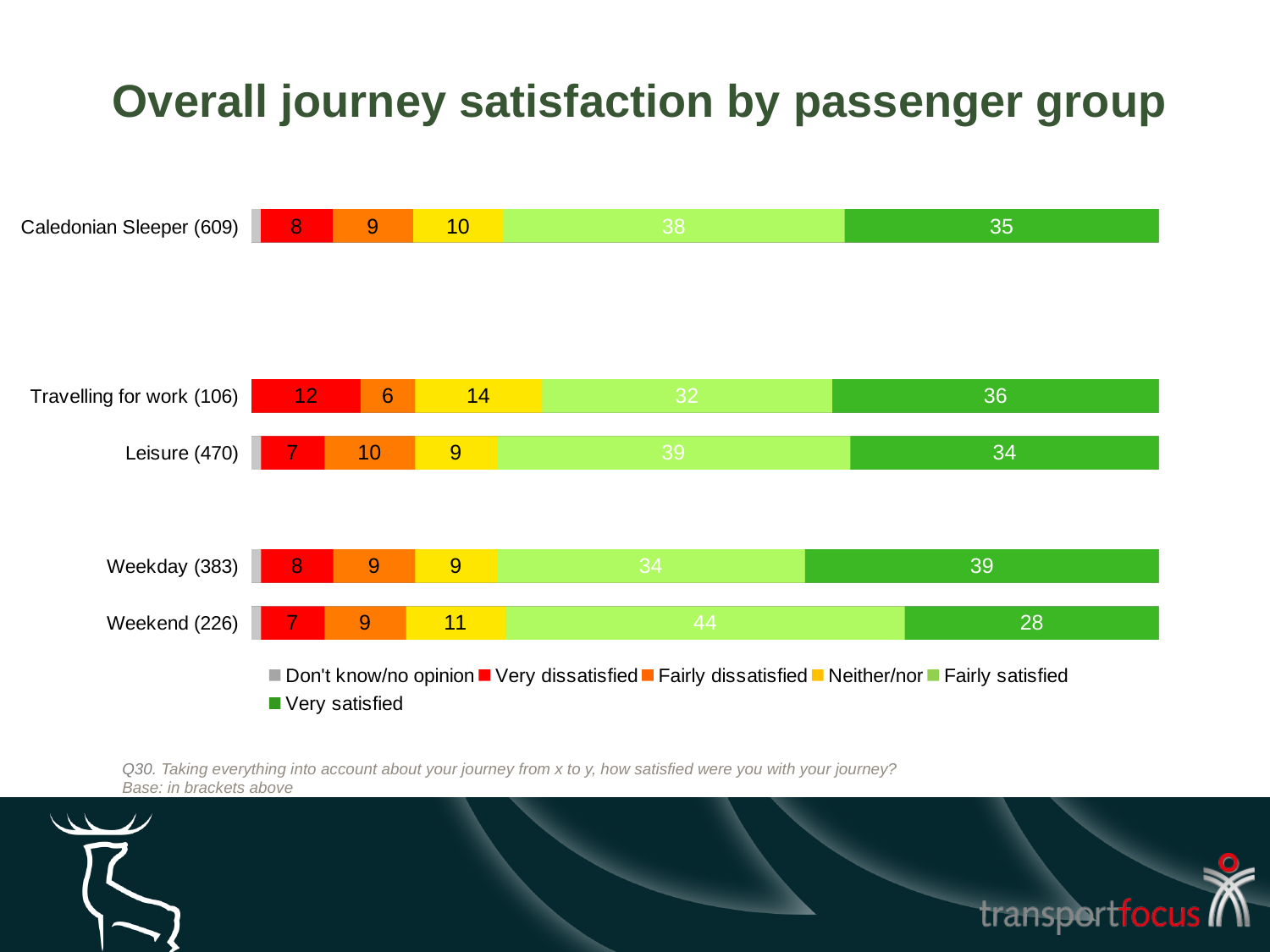
What is the Fairly satisfied value for Weekend (226)? 44 How many passenger groups are shown in the chart? 5 What kind of chart is shown on the slide? Stacked bar chart Which has the larger Neither/nor value, Travelling for work (106) or Weekend (226)? Travelling for work (106) Which passenger group has the lowest Very satisfied value? Weekend (226) What is the difference between the Very satisfied values for Weekday (383) and Weekend (226)? 11 What is the Very satisfied value for Weekday (383)? 39 Which passenger group has the highest Very satisfied value? Weekday (383) Which passenger group has the highest Fairly satisfied value? Weekend (226) How many series does the legend list? 6 What is the Fairly dissatisfied value for Leisure (470)? 10 What is the Very dissatisfied value for Travelling for work (106)? 12